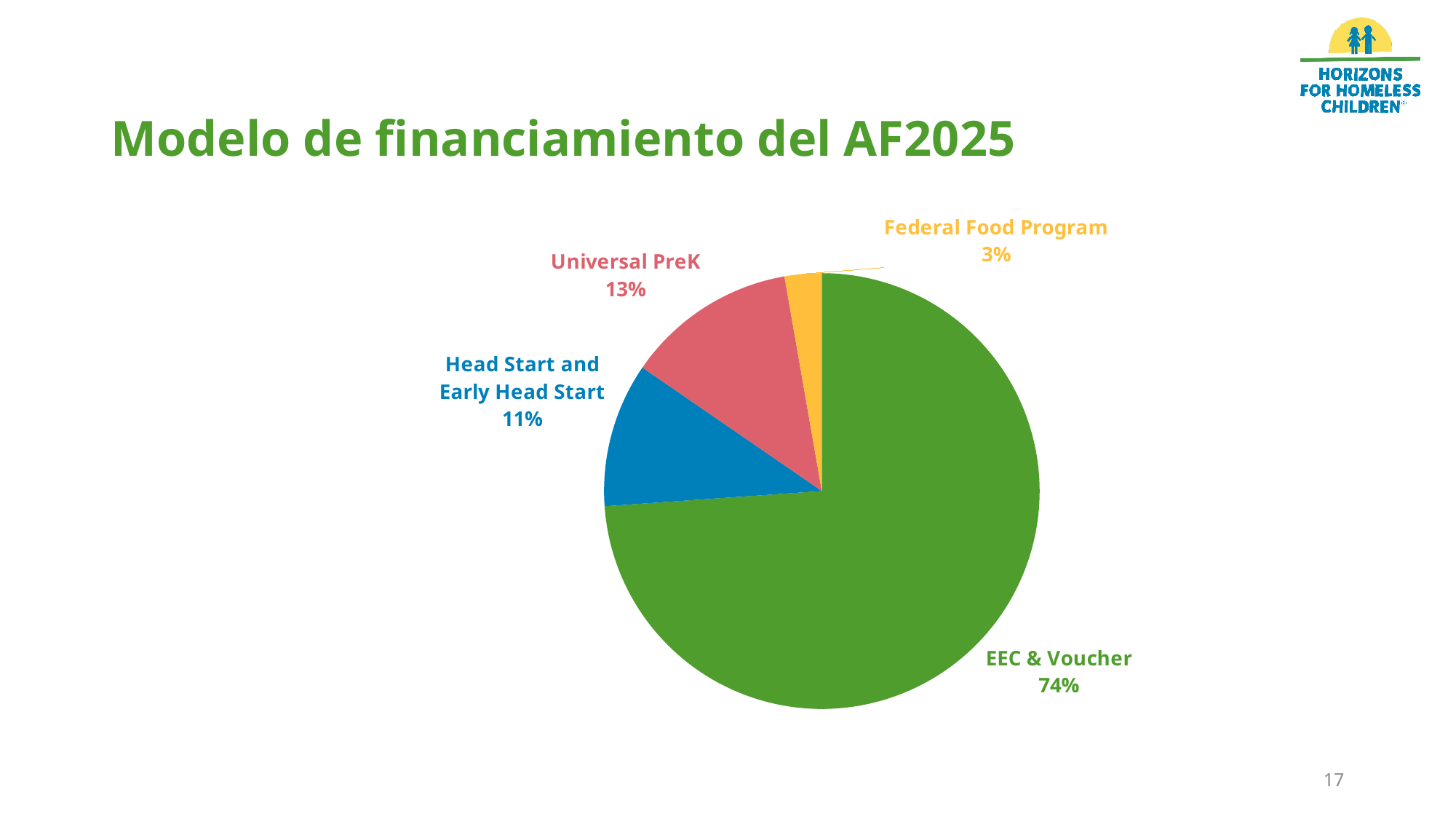
How many slices does the pie chart have? 4 Which category has the largest slice of the pie? EEC & Voucher What share of the pie does the Federal Food Program represent? 3% What is the difference in percentage points between Universal PreK and Head Start and Early Head Start? 2 What is the difference in percentage points between EEC & Voucher and Universal PreK? 61 What kind of chart is shown on the slide? Pie chart What percentage is shown for Head Start and Early Head Start? 11% What share of the pie does EEC & Voucher represent? 74% What colour is the EEC & Voucher slice? Green What percentage is shown for Universal PreK? 13% Which is larger, the Universal PreK slice or the Head Start and Early Head Start slice? Universal PreK Which category has the smallest slice of the pie? Federal Food Program